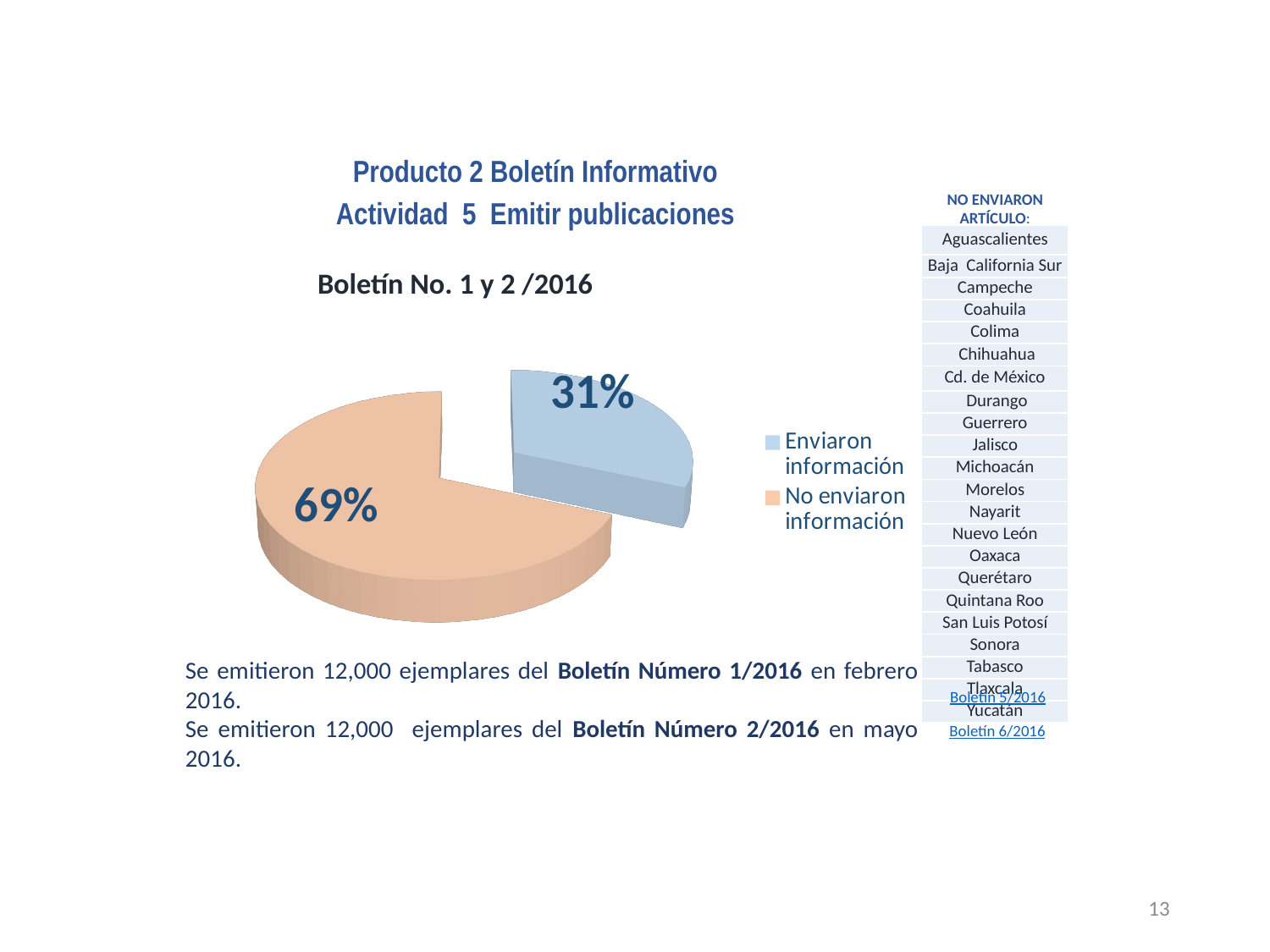
What percentage of the pie is labelled 'Enviaron información'? 31% Which is larger: the 'Enviaron información' slice or the 'No enviaron información' slice? No enviaron información What is the difference in percentage points between the 'No enviaron información' slice and the 'Enviaron información' slice? 38 Which slice of the pie is the smallest? Enviaron información Is the share for 'Enviaron información' greater or less than 50%? less How many entries does the chart legend list? 2 What colour is the 'No enviaron información' slice? peach/orange What kind of chart is shown on the slide? pie chart What percentage of the pie is labelled 'No enviaron información'? 69% Which slice of the pie is the largest? No enviaron información How many slices does the pie chart have? 2 What is the title of the chart? Boletín No. 1 y 2 /2016